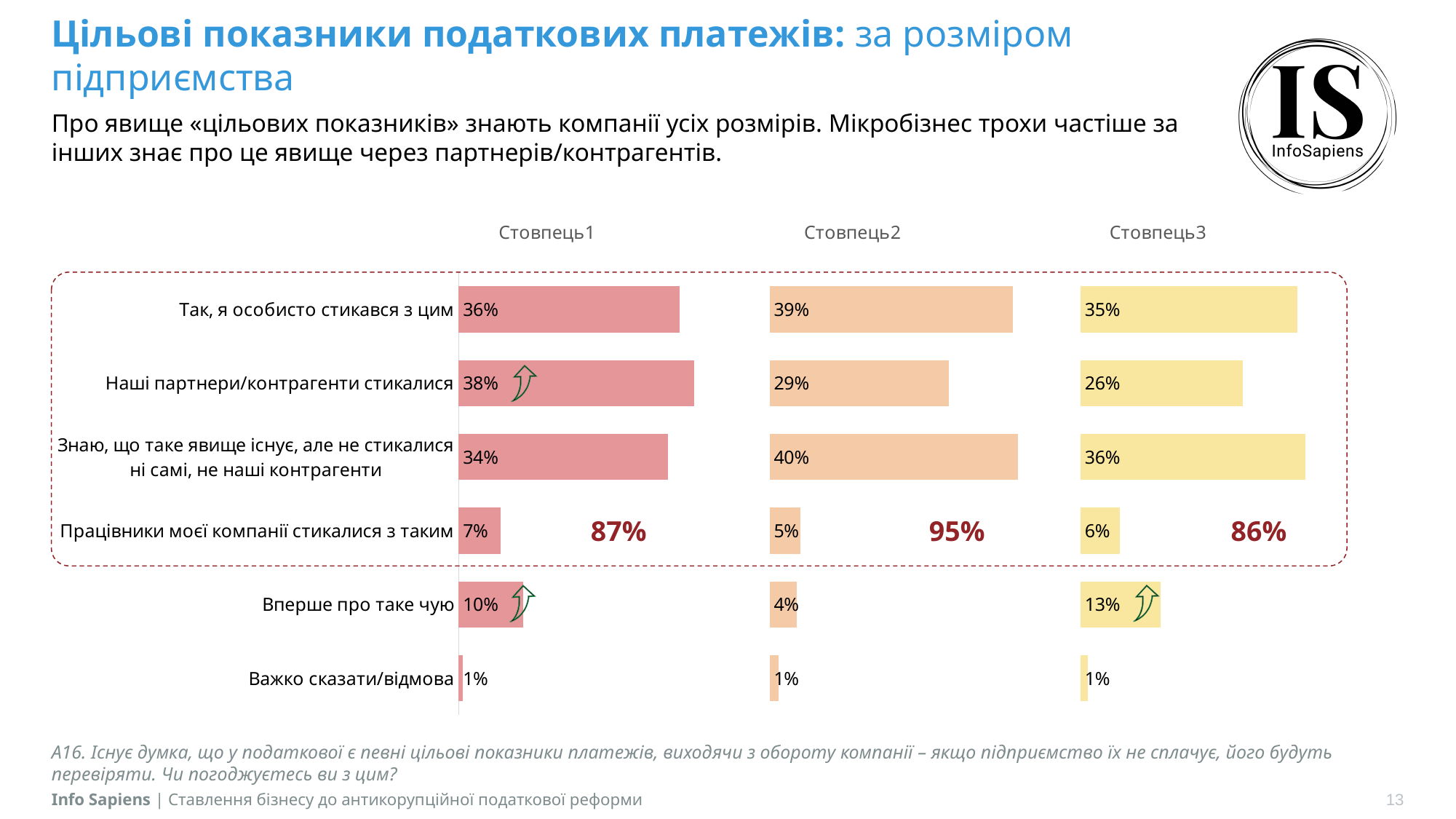
How many series (columns) does the chart show? 3 Which category has the highest value in Стовпець2? Знаю, що таке явище існує, але не стикалися ні самі, не наші контрагенти What is the difference between Стовпець1 and Стовпець2 for «Наші партнери/контрагенти стикалися»? 9% Which category has the lowest value in Стовпець1? Важко сказати/відмова What kind of chart is shown on the slide? Bar chart What is the value for «Працівники моєї компанії стикалися з таким» in Стовпець3? 6% How many categories are shown in the chart? 6 What is the value for «Вперше про таке чую» in Стовпець3? 13% Which is larger for «Вперше про таке чую»: Стовпець1 or Стовпець3? Стовпець3 What summary percentage is shown in the dashed box for Стовпець2? 95% What is the value for «Знаю, що таке явище існує, але не стикалися ні самі, не наші контрагенти» in Стовпець2? 40% What is the value for «Наші партнери/контрагенти стикалися» in Стовпець1? 38%